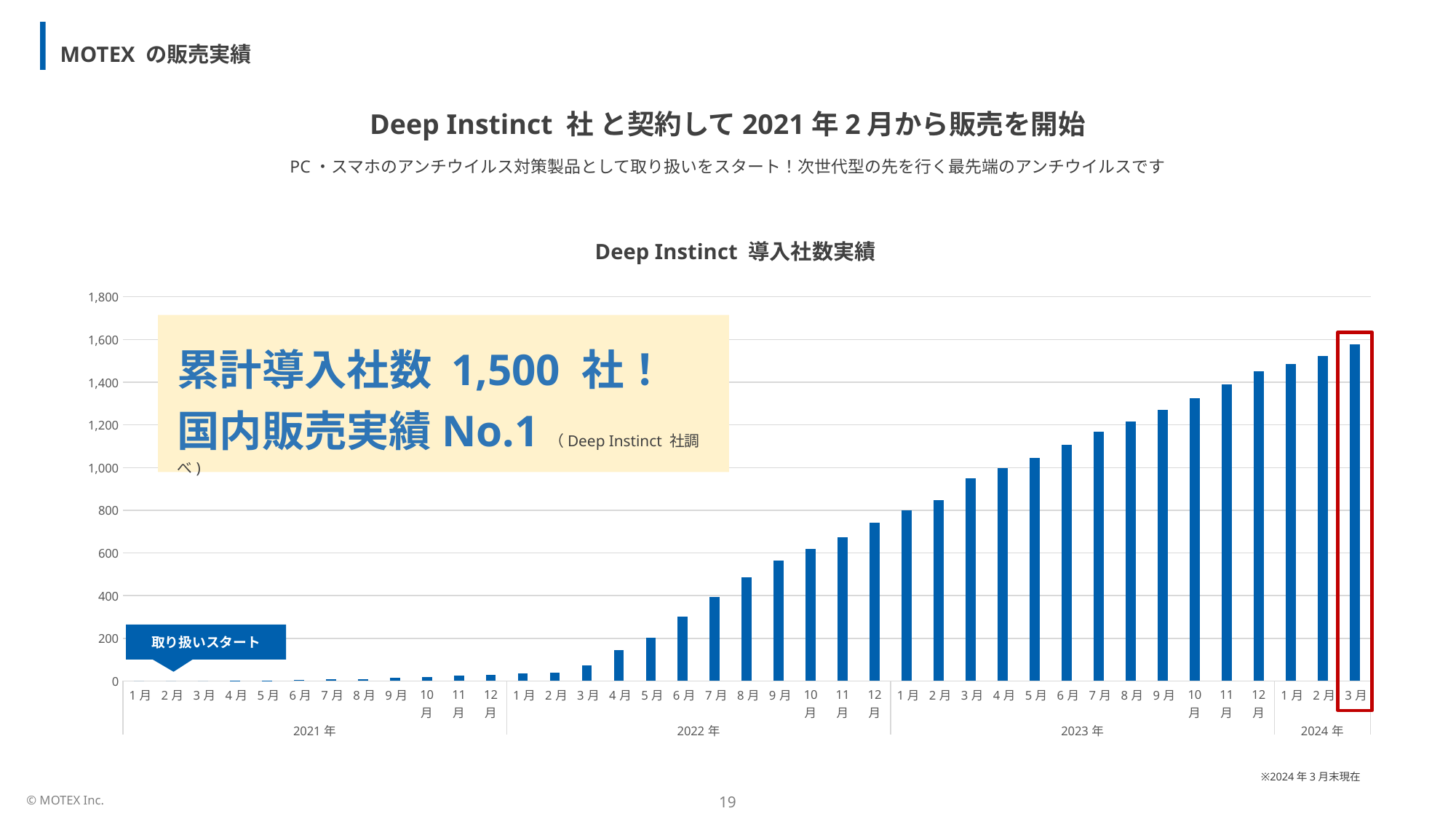
Do the values rise or fall along the x axis from 2021年 to 2024年? Rise Is the value for 2021年12月 greater or less than 200? less Is the value for 2023年6月 greater or less than 1,000? greater Which month has the highest value in the chart? 2024年3月 Is the value for 2022年12月 greater or less than 800? less What is the title of the chart? Deep Instinct 導入社数実績 How many monthly bars are plotted in the chart? 39 Which is larger, the value for 2023年12月 or the value for 2022年12月? 2023年12月 Which month's bar is outlined with a red box in the chart? 2024年3月 What kind of chart is shown on the slide? Bar chart